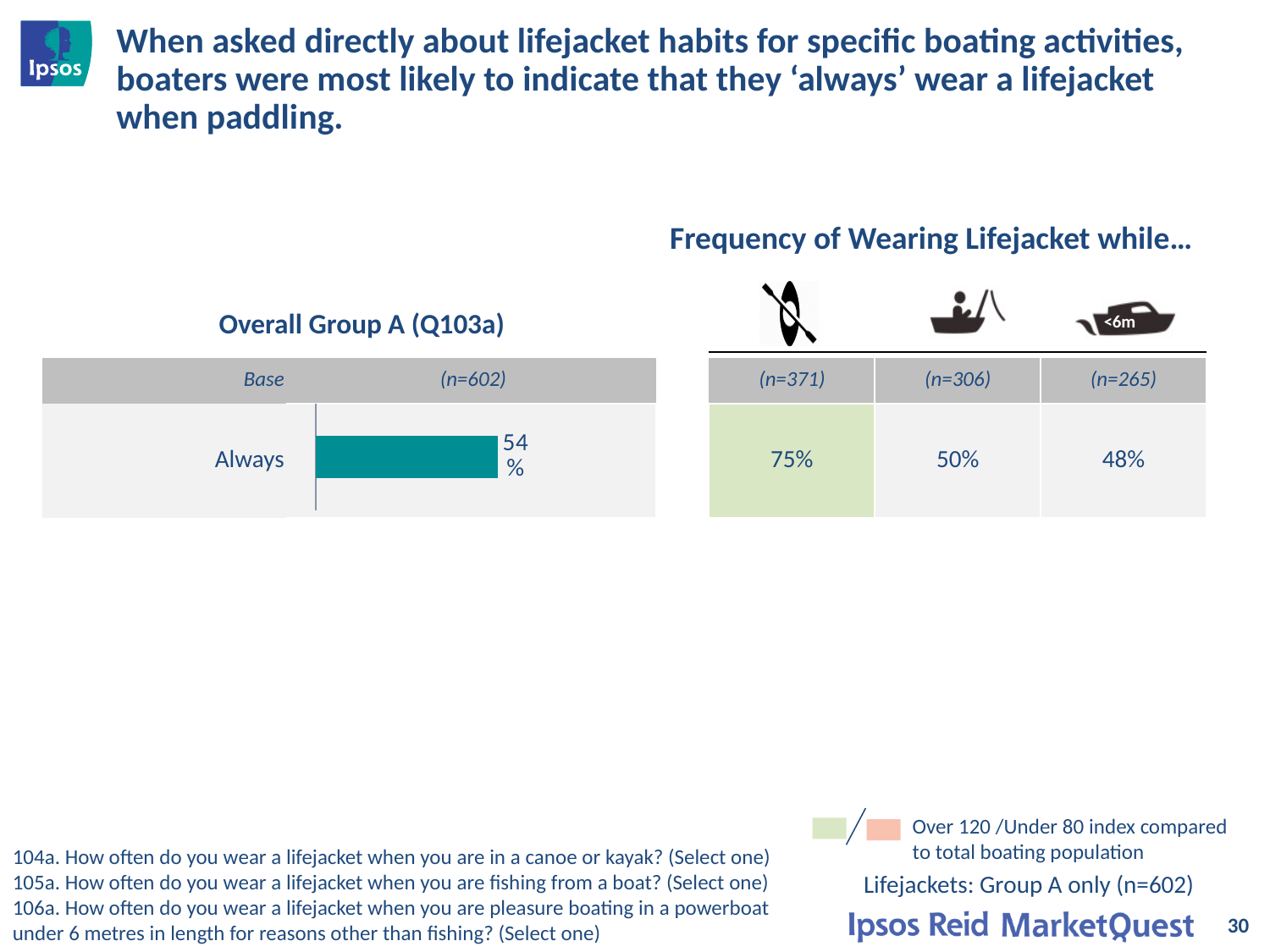
What is the title of the bar chart on the left of the slide? Overall Group A (Q103a) Is the 'Always' percentage higher for canoe/kayak (n=371) or for fishing from a boat (n=306)? canoe/kayak In the 'Frequency of Wearing Lifejacket while…' table, what percentage always wear a lifejacket when pleasure boating in a powerboat under 6m (n=265)? 48% In the 'Frequency of Wearing Lifejacket while…' table, what percentage always wear a lifejacket when fishing from a boat (n=306)? 50% What is the base size shown for the Overall Group A (Q103a) chart? (n=602) In the 'Frequency of Wearing Lifejacket while…' table, what is the difference between the canoe/kayak value and the powerboat under 6m value? 27 percentage points In the Overall Group A (Q103a) chart, what percentage of boaters say they 'Always' wear a lifejacket? 54% What kind of chart is the Overall Group A (Q103a) chart? bar chart In the 'Frequency of Wearing Lifejacket while…' table, which activity has the highest percentage of boaters always wearing a lifejacket? canoe or kayak (75%) In the 'Frequency of Wearing Lifejacket while…' table, what percentage always wear a lifejacket when in a canoe or kayak (n=371)? 75% Is the 'Always' value in the Overall Group A (Q103a) chart greater or less than 50%? greater How many categories are plotted in the Overall Group A (Q103a) bar chart? 1